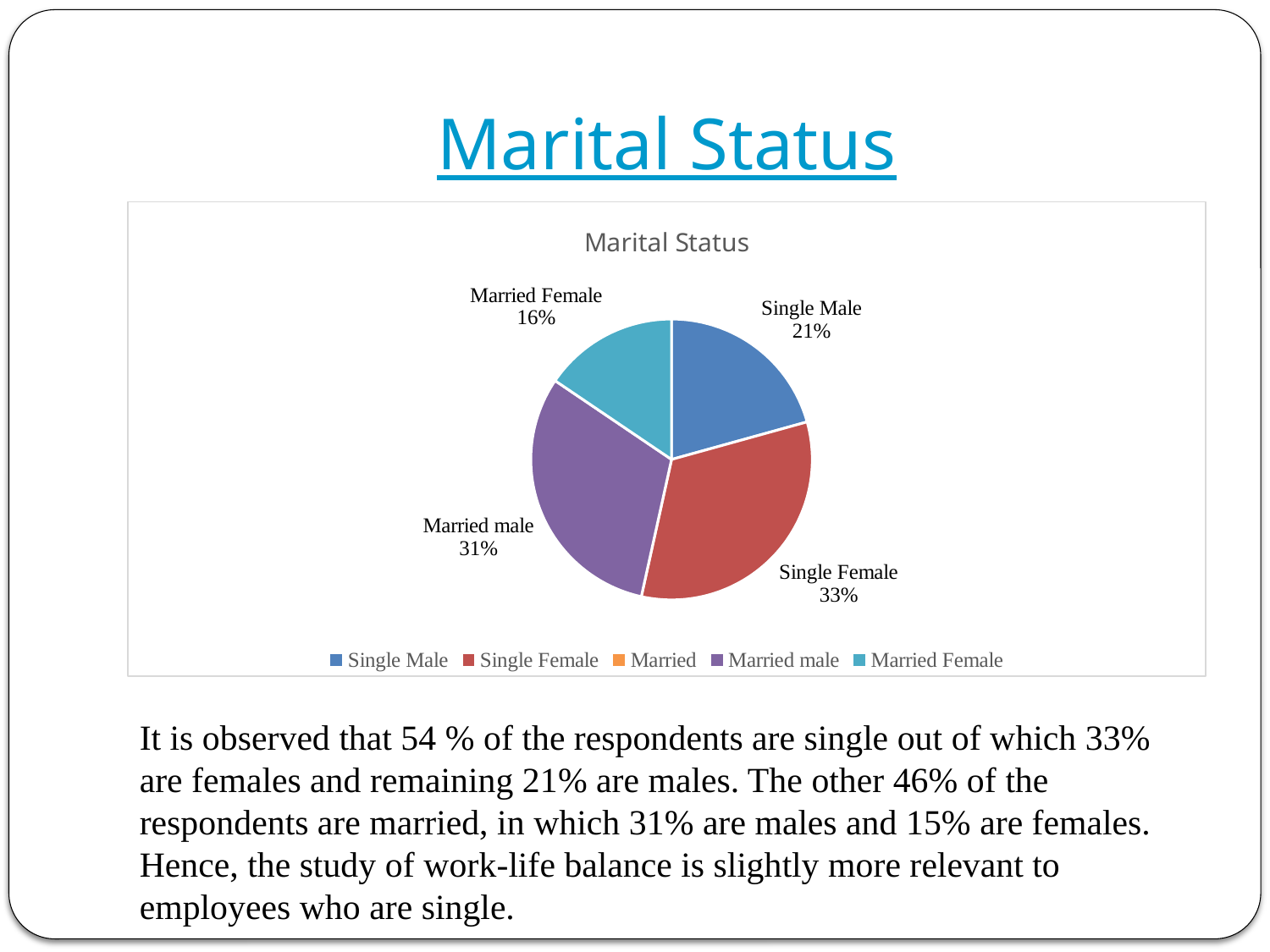
Which category has the smallest share of the pie? Married Female What type of chart is shown on the slide? pie chart How many slices are shown in the pie chart? 4 What percentage of respondents are Married Female? 16% What percentage of respondents are Married male? 31% What percentage of respondents are Single Male? 21% How many entries does the legend list? 5 What percentage of respondents are Single Female? 33% Which category has the largest share of the pie? Single Female What is the difference in percentage points between Single Female and Single Male? 12% What is the difference in percentage points between Married male and Married Female? 15% Which is larger, the share for Married male or the share for Single Male? Married male